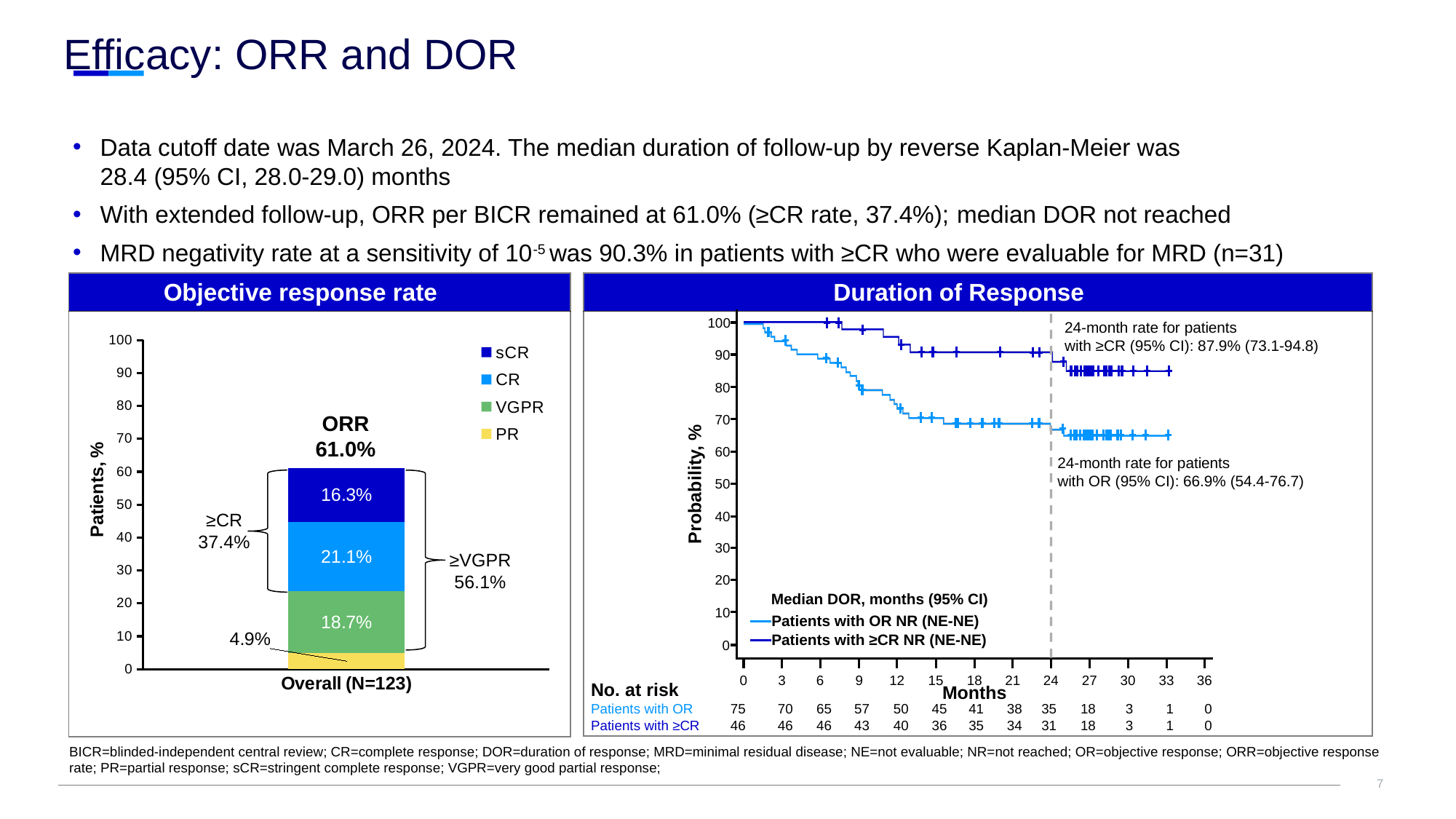
In the Objective response rate chart, what is the difference between the CR and VGPR values? 2.4% In the Objective response rate chart, which response category has the smallest segment? PR In the Duration of Response chart, which curve is higher at 24 months, Patients with OR or Patients with ≥CR? Patients with ≥CR In the Duration of Response chart, how many Patients with OR were at risk at 12 months? 50 In the Objective response rate chart, what is the value for PR? 4.9% What kind of chart is the Objective response rate chart? Stacked bar chart In the Objective response rate chart, what is the value for sCR? 16.3% In the Objective response rate chart, which response category has the largest segment? CR In the Duration of Response chart, does the probability for Patients with OR rise or fall over the months? Fall In the Objective response rate chart, what is the total of the stacked bar (ORR)? 61.0% How many series does the legend of the Objective response rate chart list? 4 In the Duration of Response chart, what is the 24-month rate for patients with ≥CR? 87.9%